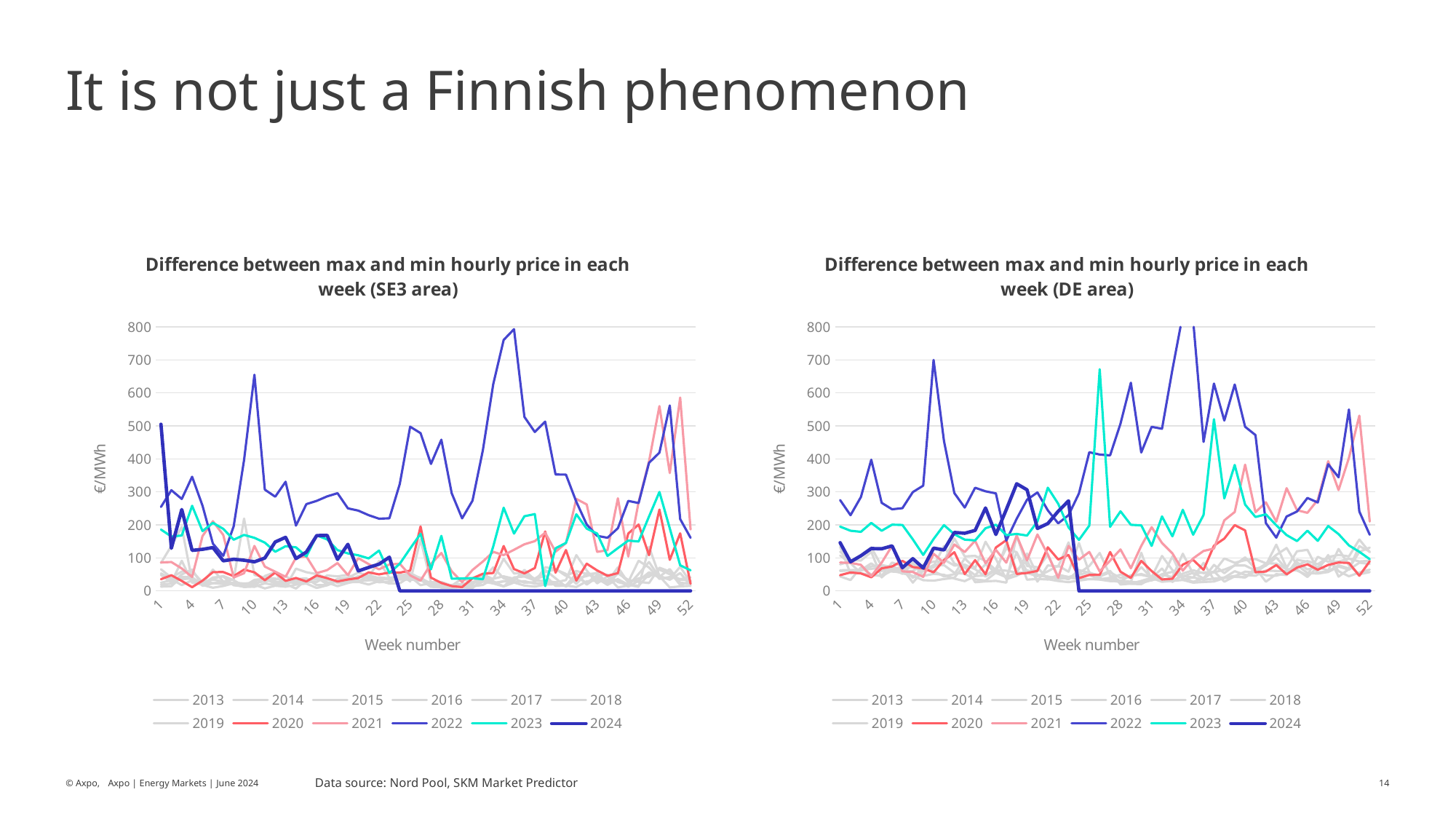
In the left chart (SE3 area), which year's line reaches the highest value? 2022 In the right chart (DE area), is the value for 2024 at week 1 greater or less than 200? less What kind of chart is the left chart, 'Difference between max and min hourly price in each week (SE3 area)'? line chart How many series does the legend of the right chart (DE area) list? 12 In the left chart (SE3 area), is the value for 2024 at week 1 greater or less than 400? greater In the right chart (DE area), which year's line reaches the highest value? 2022 In the left chart (SE3 area), is the value for 2022 at week 34 greater or less than 700? greater What is the title of the right chart? Difference between max and min hourly price in each week (DE area) What unit is shown on the y axis of the left chart (SE3 area)? €/MWh In the right chart (DE area), which is larger at week 10: the value for 2022 or the value for 2024? 2022